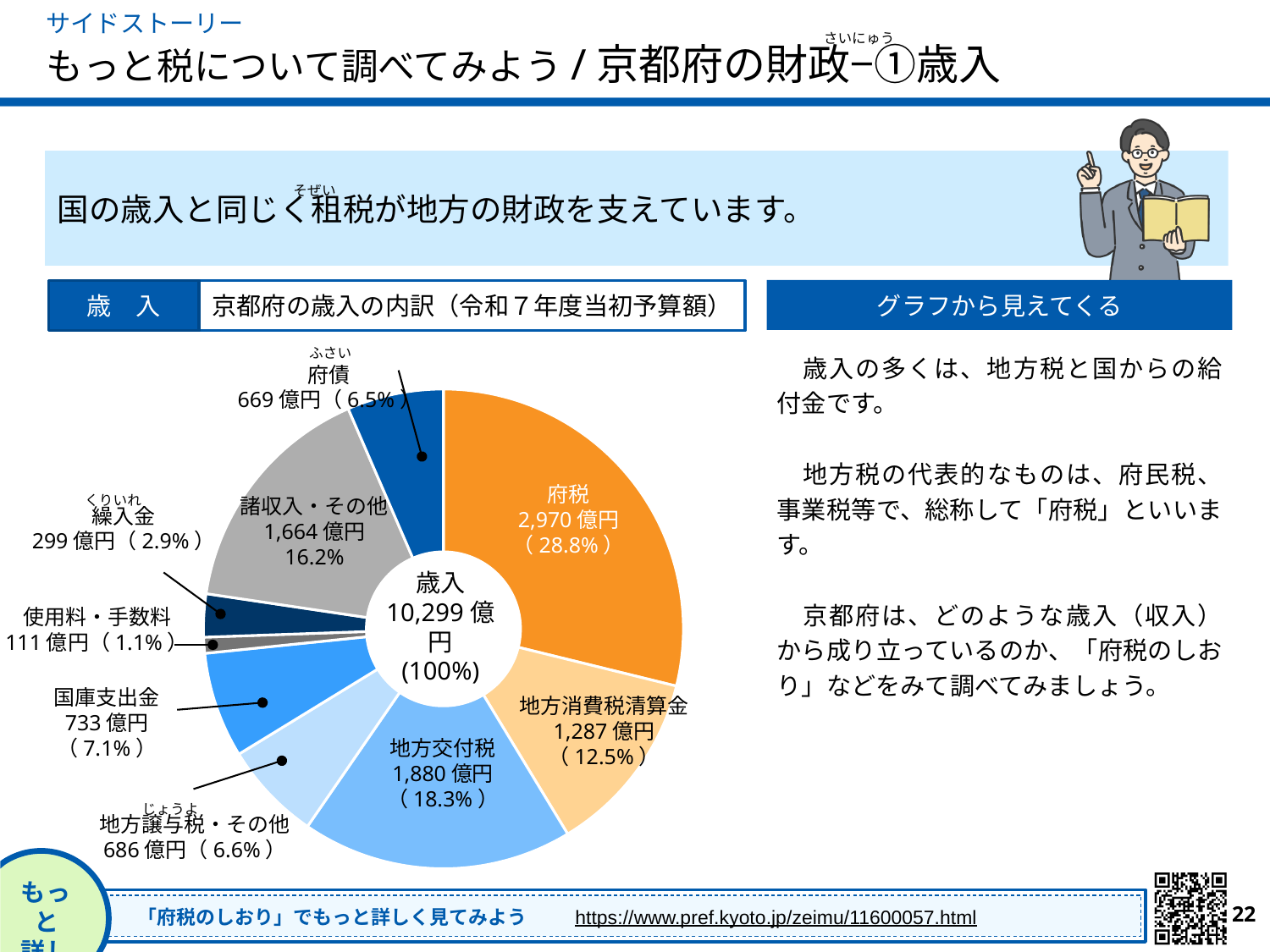
What is the title of the pie chart? 京都府の歳入の内訳（令和７年度当初予算額） What is the difference in 億円 between 府税 and 地方交付税? 1,090 億円 What is the value for 府税 in the pie chart? 2,970 億円 What share of the pie does 地方交付税 represent? 18.3% What kind of chart is shown on the slide? Pie chart What share of the pie does 府債 represent? 6.5% How many categories are shown in the pie chart? 9 What is the value for 国庫支出金? 733 億円 Which is larger, 地方消費税清算金 or 諸収入・その他? 諸収入・その他 Which category has the largest share of the pie? 府税 Which category has the smallest share of the pie? 使用料・手数料 What is the total 歳入 shown in the centre of the pie chart? 10,299 億円